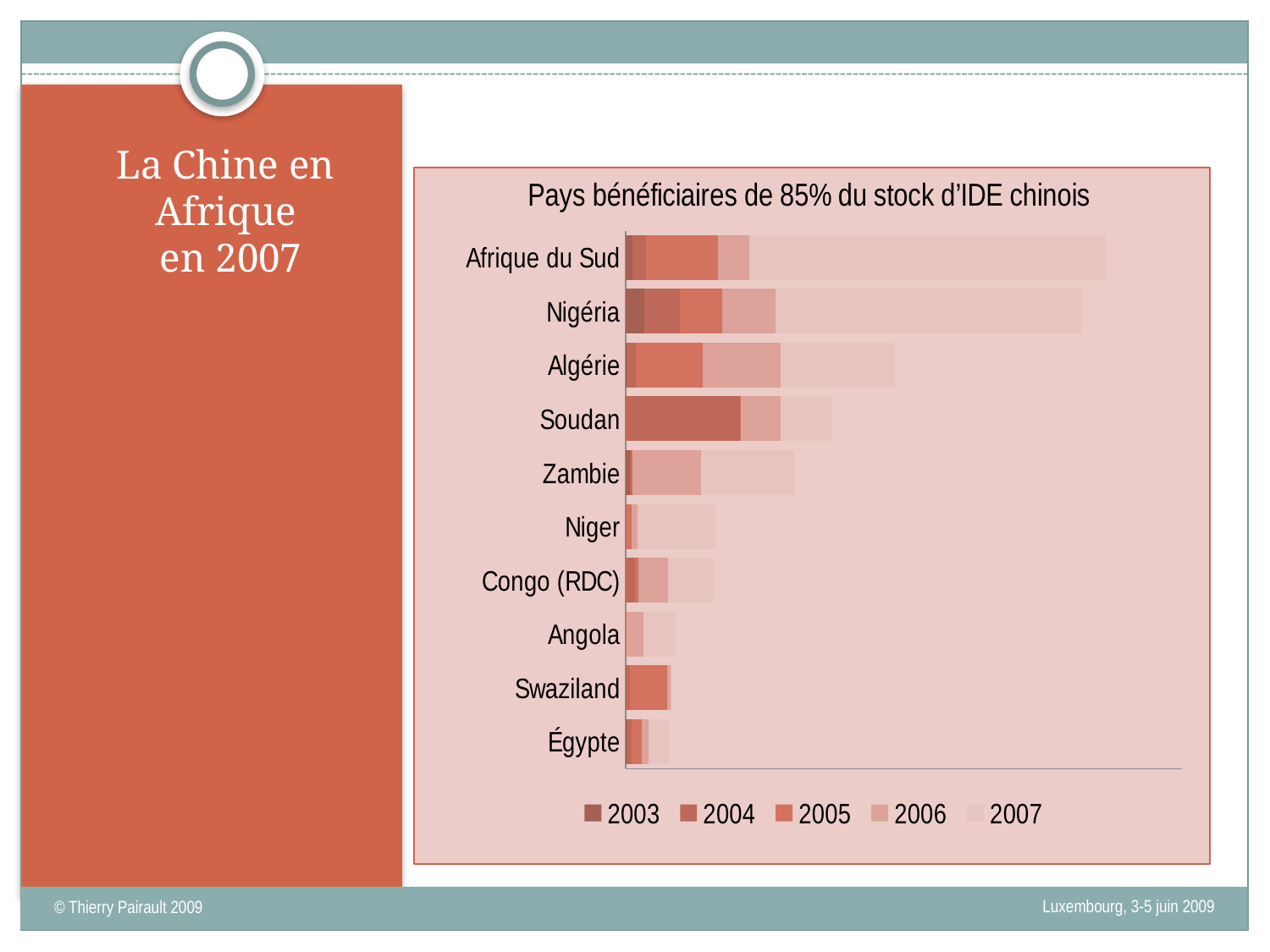
Which has the longer overall bar, Nigéria or Algérie? Nigéria Which years are listed in the chart legend? 2003, 2004, 2005, 2006, 2007 What kind of chart is shown on the slide? Stacked bar chart Which has the longer overall bar, Soudan or Congo (RDC)? Soudan Which country has the longest overall bar on the chart? Afrique du Sud Which has the longer overall bar, Algérie or Soudan? Algérie How many countries are listed on the chart? 10 What is the title of the chart? Pays bénéficiaires de 85% du stock d'IDE chinois How many series does the legend list? 5